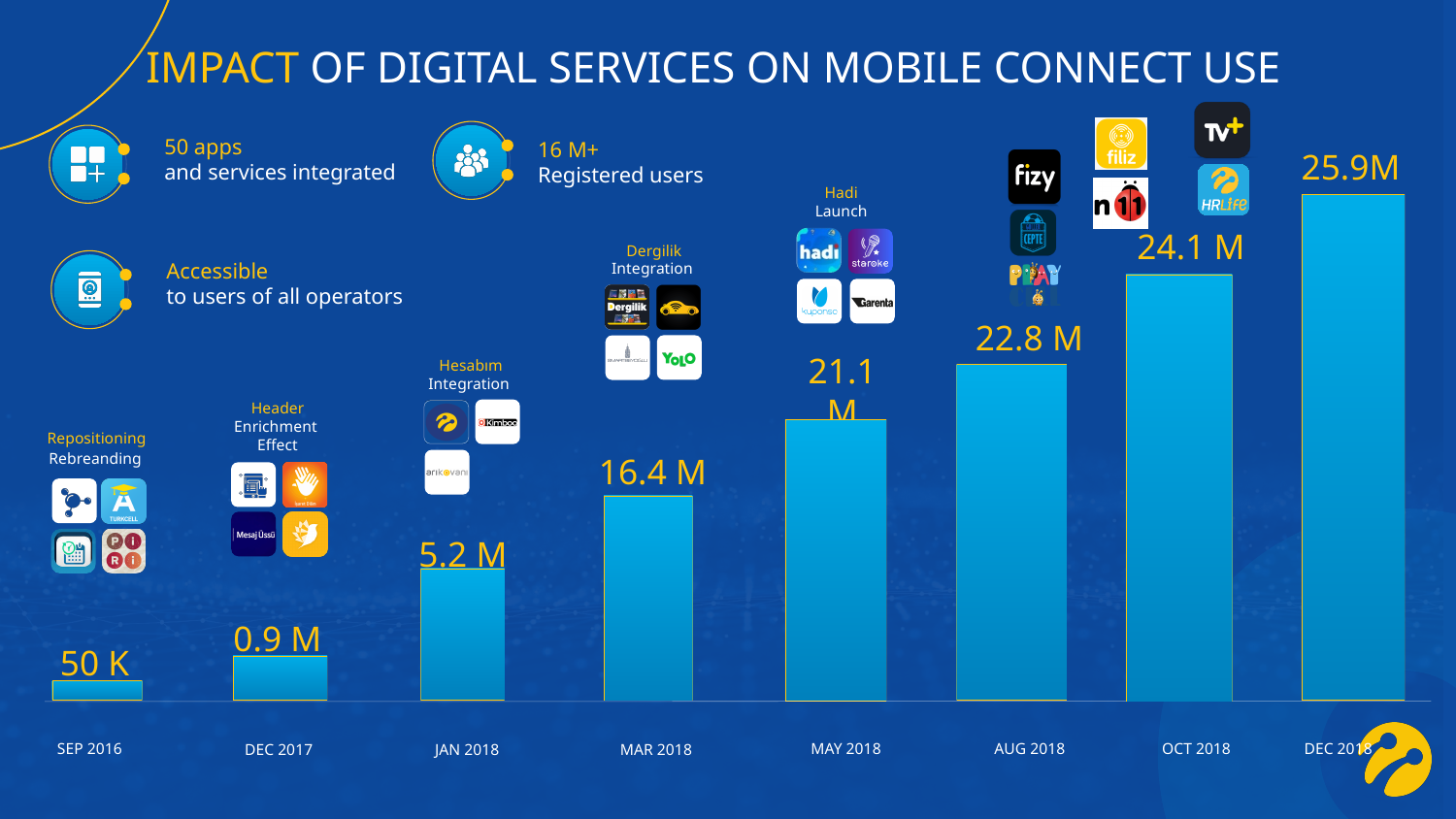
What value is shown for DEC 2018? 25.9M What value is shown for MAR 2018? 16.4 M Which period has the highest value? DEC 2018 How many periods are shown on the x axis? 8 What value is shown for AUG 2018? 22.8 M What is the difference between the values for MAR 2018 and JAN 2018? 11.2 M What kind of chart is shown on the slide? Bar chart What is the difference between the values for DEC 2018 and OCT 2018? 1.8 M Which period has the lowest value? SEP 2016 What value is shown for SEP 2016? 50 K Which is larger, the value for MAY 2018 or the value for AUG 2018? AUG 2018 Do the values rise or fall from SEP 2016 to DEC 2018? Rise